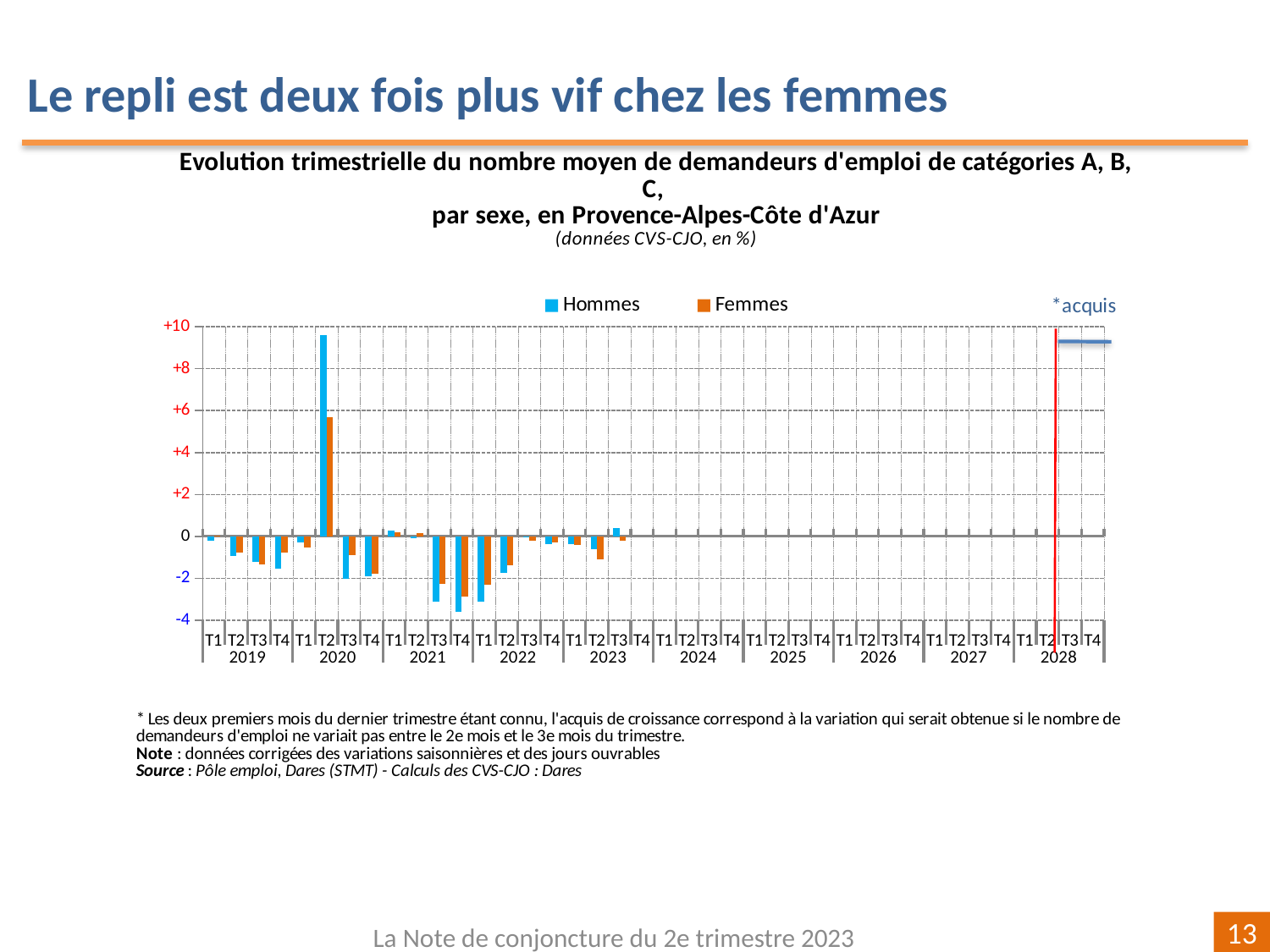
Which colour represents the Femmes series? orange How many years are labelled along the x axis? 10 What are the two series named in the legend? Hommes and Femmes Is the Hommes value for T2 2020 greater or less than +8? greater Is the Hommes value for T3 2021 greater or less than -2? less Is the Femmes value for T2 2020 greater or less than +4? greater In which quarter is the Hommes value highest? T2 2020 In T2 2020, which series has the larger value, Hommes or Femmes? Hommes What kind of chart is shown on the slide? bar chart How many series does the legend list? 2